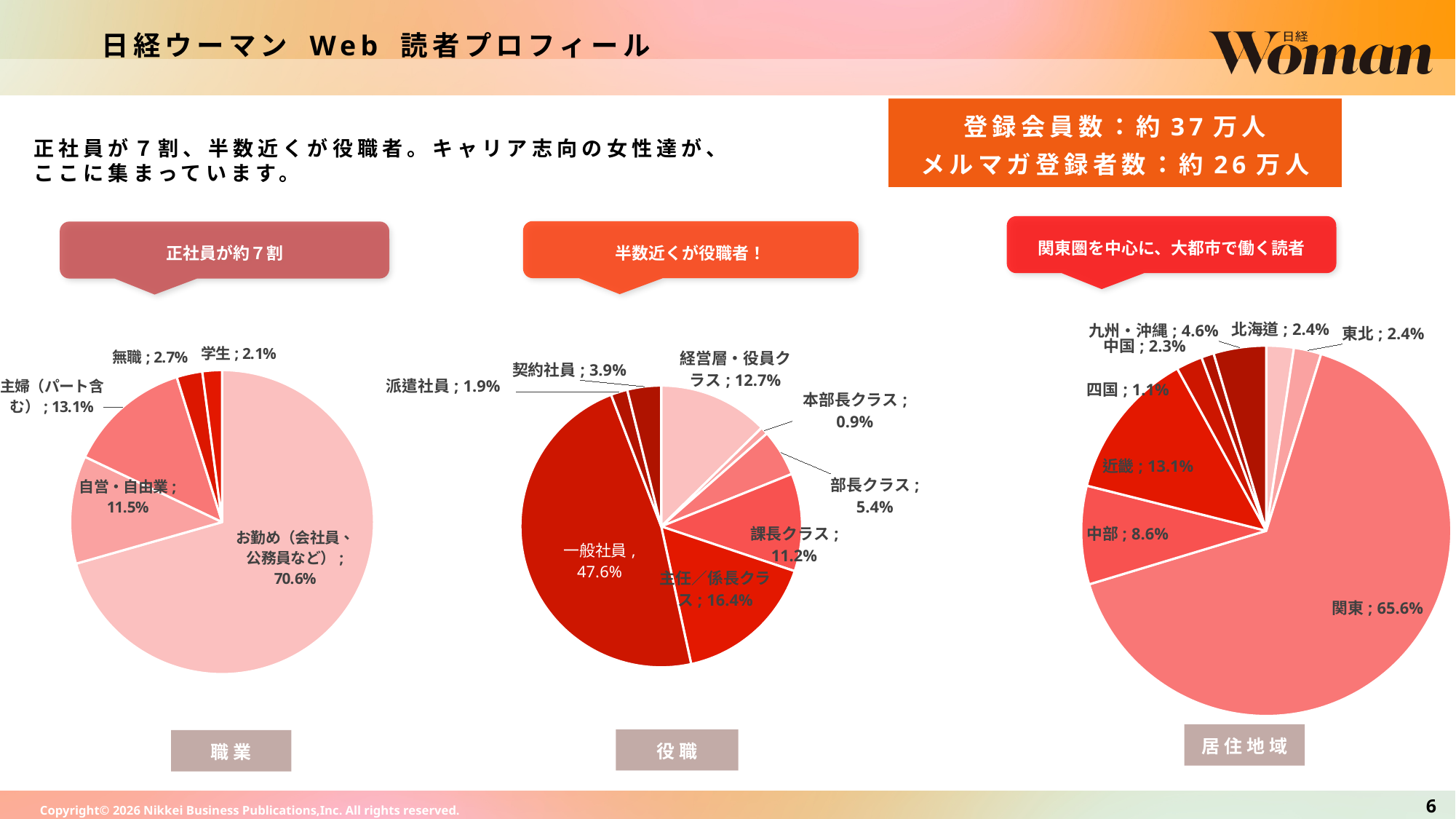
In the 役職 pie chart, which is larger, 経営層・役員クラス or 課長クラス? 経営層・役員クラス What type of chart is used for 居住地域? Pie chart In the 役職 pie chart, which category has the smallest share? 本部長クラス In the 職業 pie chart, which category has the smallest share? 学生 In the 居住地域 pie chart, what is the difference between 近畿 and 中部? 4.5% In the 居住地域 pie chart, what is the share for 関東? 65.6% In the 職業 pie chart, what is the share for お勤め（会社員、公務員など）? 70.6% In the 職業 pie chart, how many categories are shown? 5 In the 居住地域 pie chart, which region has the largest share? 関東 In the 役職 pie chart, what is the share for 一般社員? 47.6% In the 職業 pie chart, what is the difference between 主婦（パート含む） and 自営・自由業? 1.6% In the 役職 pie chart, how many categories are shown? 8